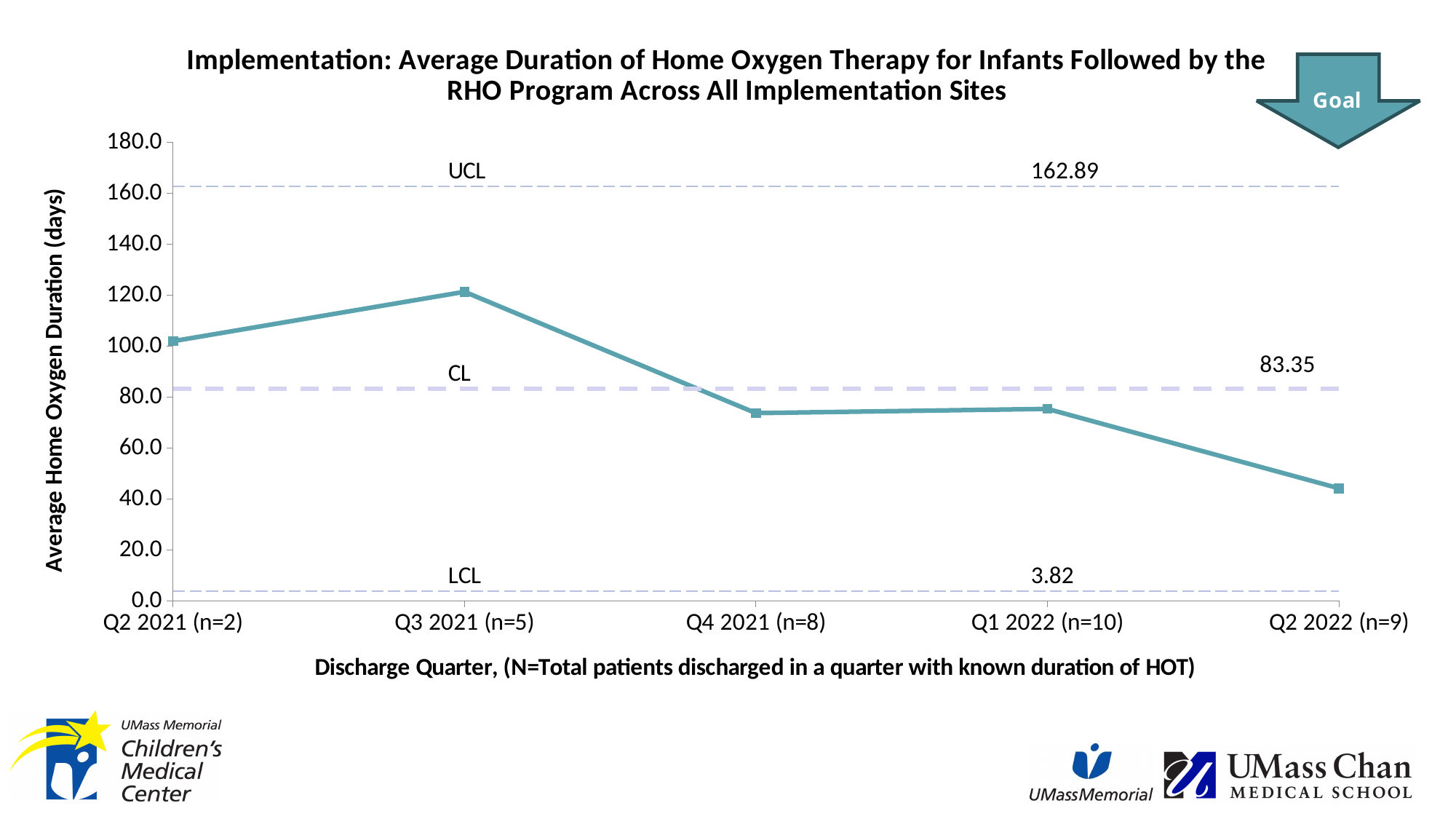
What is the value of the LCL line? 3.82 What is the value of the UCL line? 162.89 Which discharge quarter has the lowest average home oxygen duration? Q2 2022 (n=9) Which discharge quarter has the highest average home oxygen duration? Q3 2021 (n=5) How many discharge quarters are plotted on the x axis? 5 Is the value for Q2 2022 (n=9) greater or less than 60? less What kind of chart is shown on the slide? line chart What is the value of the CL line? 83.35 From Q3 2021 to Q2 2022, do the plotted values rise or fall overall? fall Which is larger, the value for Q2 2021 (n=2) or the value for Q1 2022 (n=10)? Q2 2021 (n=2) Is the value for Q4 2021 (n=8) greater or less than 80? less